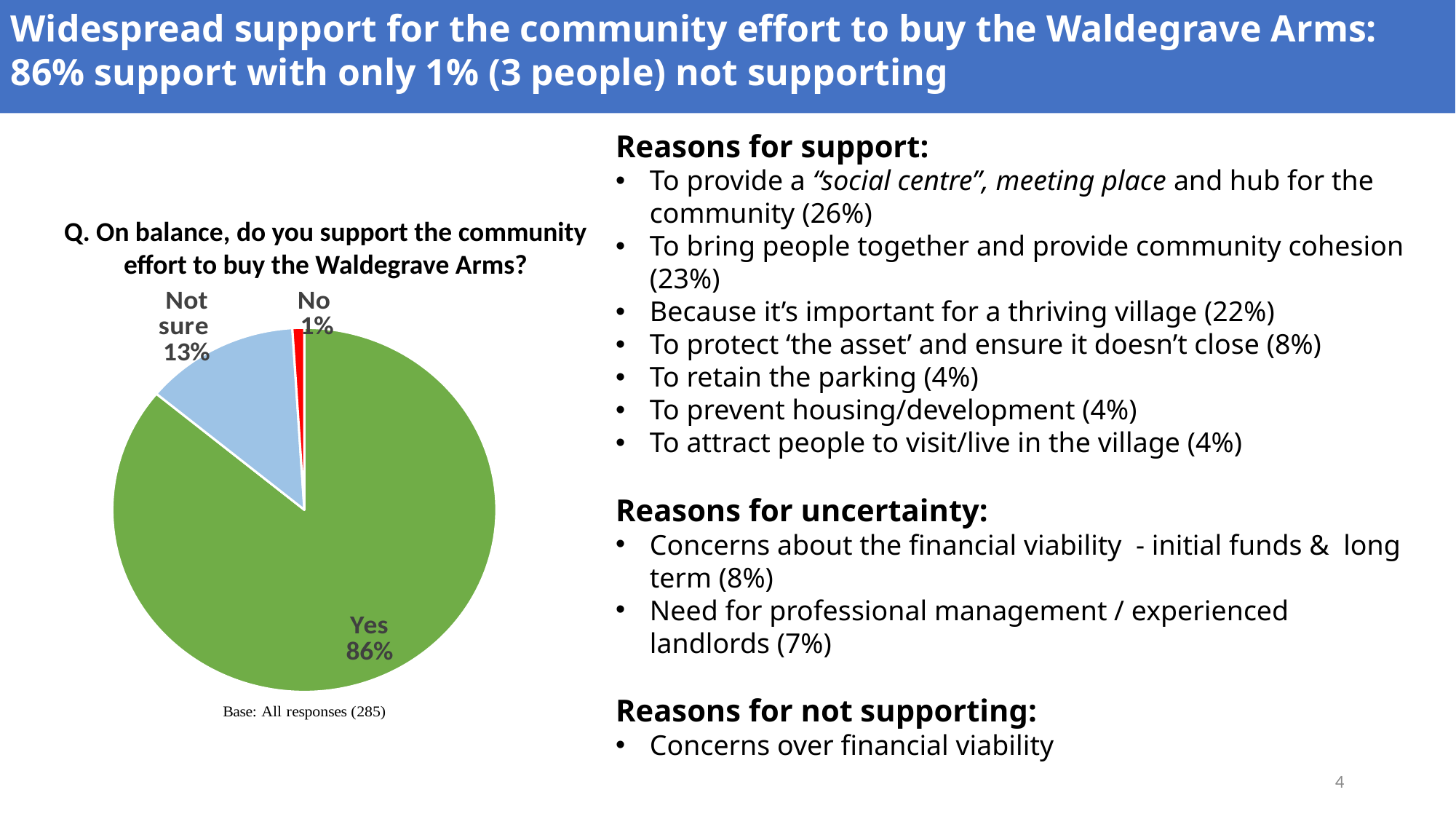
What percentage of respondents answered "Yes" to supporting the community effort to buy the Waldegrave Arms? 86% How many slices does the pie chart have? 3 What kind of chart is shown on the slide? Pie chart What is the base (number of responses) stated below the pie chart? 285 What share of the pie does the "Not sure" slice represent? 13% Which response has the largest share of the pie? Yes What percentage of respondents answered "No"? 1% What percentage of respondents answered "Not sure"? 13% Which response has the smallest share of the pie? No Which is larger, the "Not sure" slice or the "No" slice? Not sure What colour is the "Yes" slice of the pie chart? Green What is the difference in percentage points between the "Yes" and "Not sure" slices? 73 percentage points